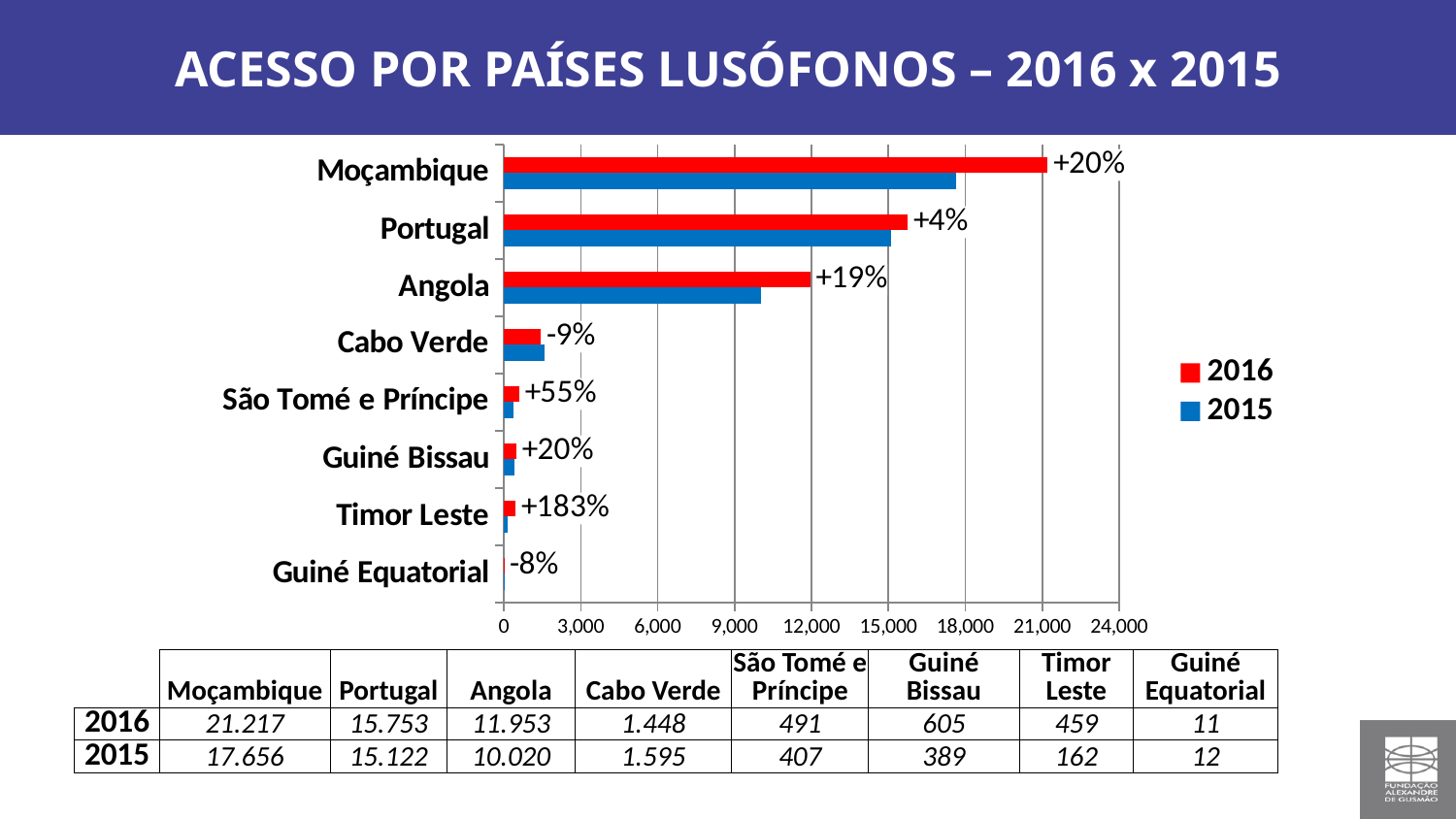
How many series does the legend list? 2 What kind of chart is shown on the slide? bar chart Which colour represents the 2016 series in the legend? red Which country has the lowest 2016 value? Guiné Equatorial What is the 2016 value for Moçambique? 21.217 How many countries are shown on the chart? 8 Is the 2016 value for Portugal greater or less than 15,000? greater Which country has the highest 2016 value? Moçambique What is the difference between the 2016 and 2015 values for Moçambique? 3.561 For Cabo Verde, which year has the larger value, 2016 or 2015? 2015 What percentage change is labelled next to the bars for Timor Leste? +183% What is the 2015 value for Angola? 10.020